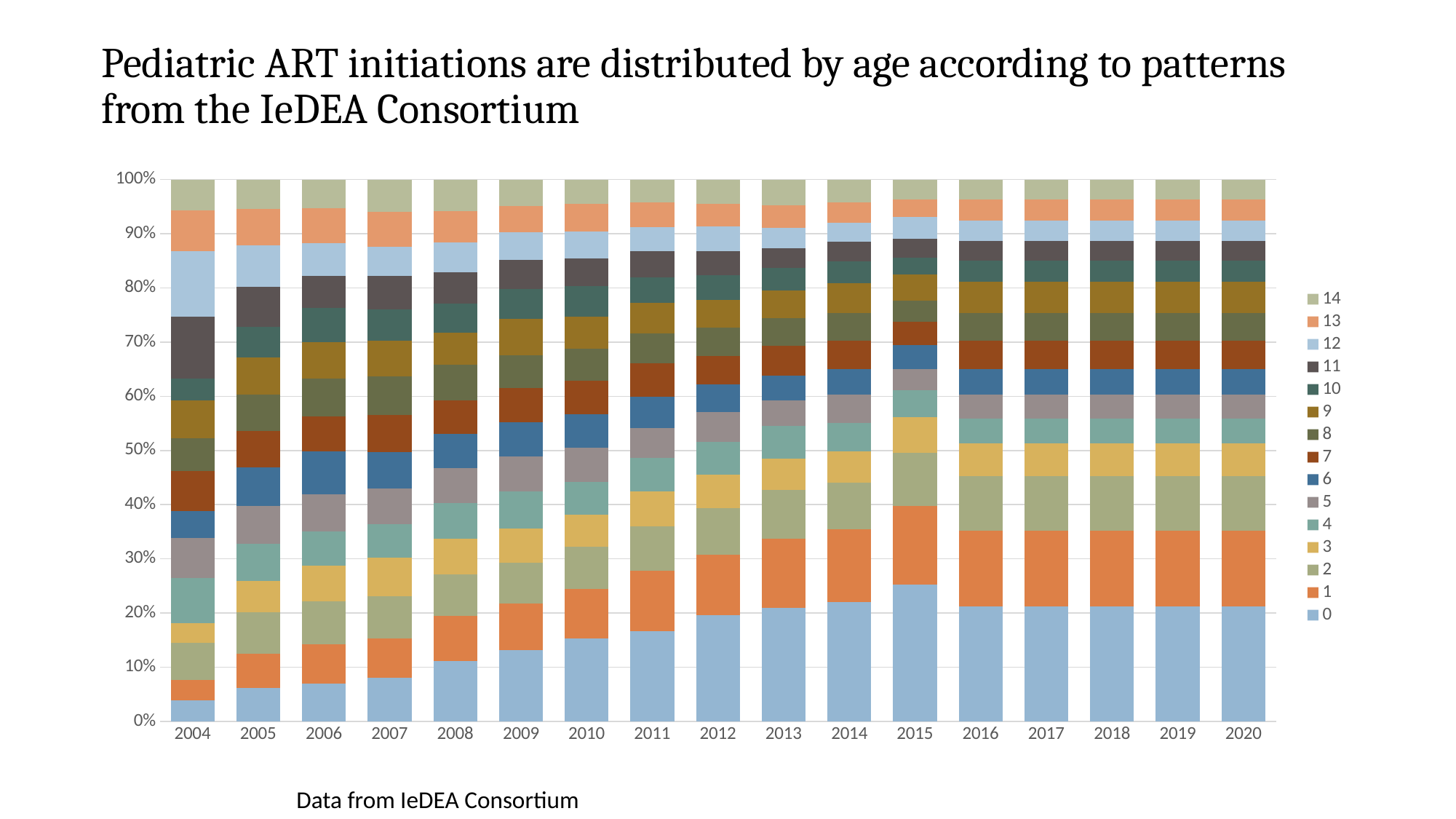
How many series does the chart's legend list? 15 What kind of chart is shown on the slide? stacked bar chart What is the first year shown on the x axis? 2004 Which year has the largest share for age 0? 2015 What is the total of the stacked bar for 2010? 100% Which year has the smallest share for age 0? 2004 Is the share for age 0 in 2004 greater or less than 10%? less Does the share for age 0 rise or fall from 2004 to 2015? rise Is the share for age 0 in 2015 greater or less than 20%? greater Which year has the larger share for age 0, 2004 or 2020? 2020 How many years are shown along the x axis of the chart? 17 Is the share for age 0 in 2011 greater or less than 20%? less